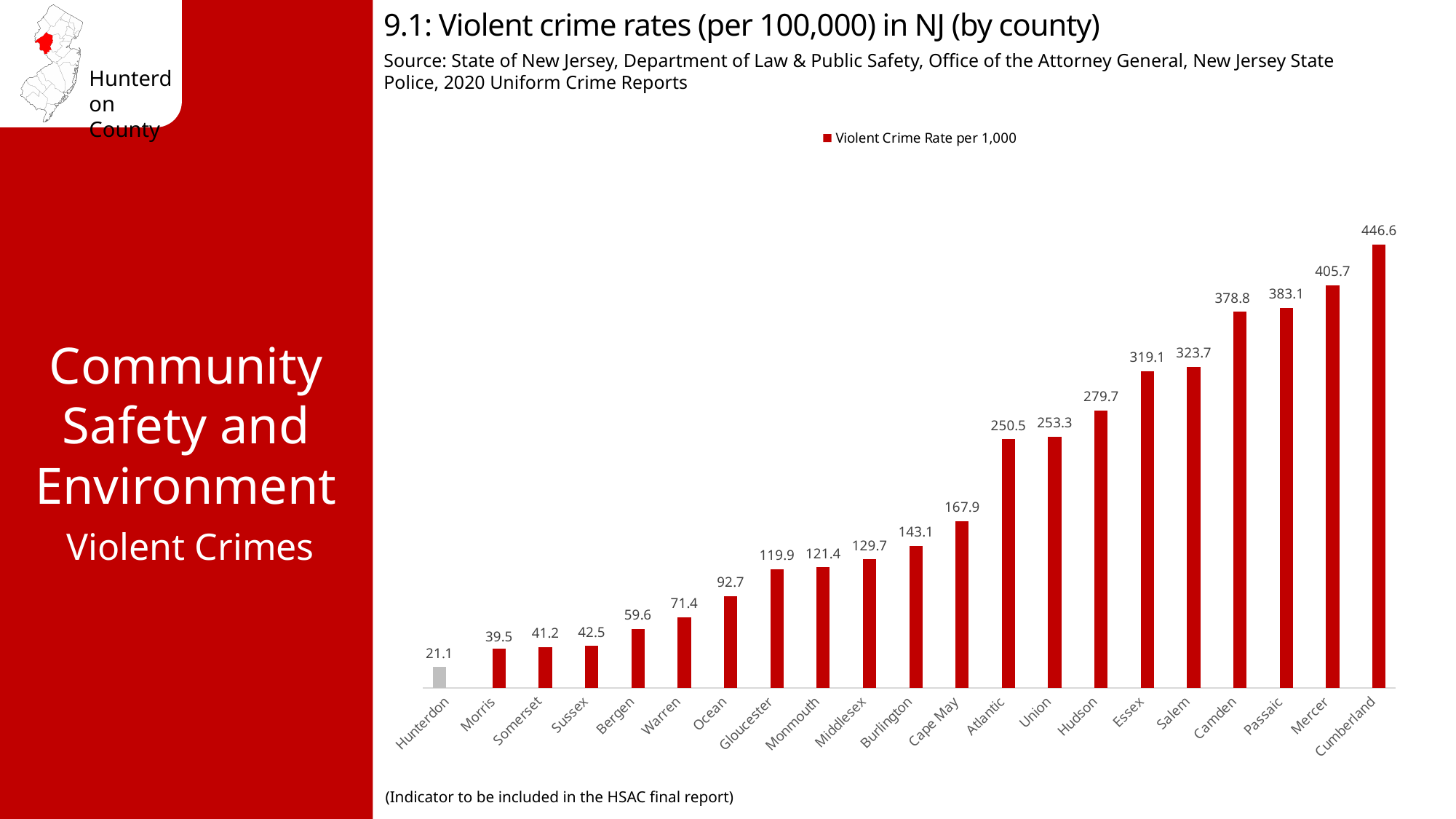
What is the violent crime rate shown for Cape May? 167.9 Which county has the lowest violent crime rate on the chart? Hunterdon What is the violent crime rate shown for Hunterdon? 21.1 What is the difference between the violent crime rates of Cumberland and Hunterdon? 425.5 Do the values rise or fall from left to right along the x axis? Rise How many series does the legend list? 1 What is the violent crime rate shown for Hudson? 279.7 Which county has a higher violent crime rate, Camden or Atlantic? Camden How many counties are shown on the chart? 21 What is the difference between the violent crime rates of Mercer and Hudson? 126.0 Which county has the highest violent crime rate on the chart? Cumberland What kind of chart is shown on the slide? Bar chart